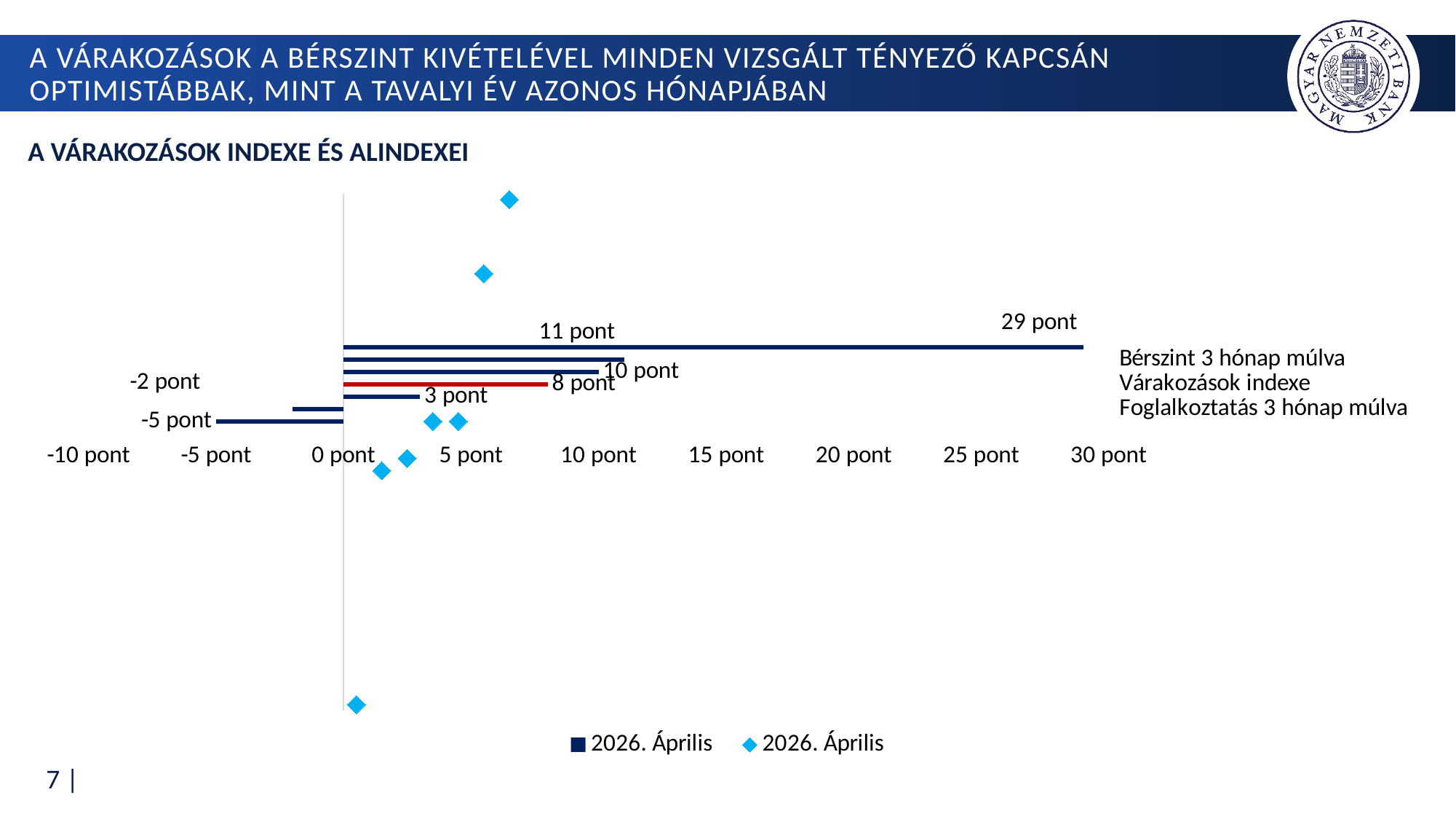
What is the highest value labelled on a bar in the chart? 29 pont How many bars carry a data label in the chart? 7 What is the highest tick value shown on the horizontal axis? 30 pont What is the difference between the longest bar (29 pont) and the bar labelled 11 pont? 18 pont What is the title of the chart? A VÁRAKOZÁSOK INDEXE ÉS ALINDEXEI What is the difference between the bars labelled 10 pont and 8 pont? 2 pont What kind of chart is shown on the slide? bar chart How many series does the legend list? 2 Is the longest bar in the chart greater or less than 25 pont? greater How many bars in the chart have negative values? 2 Which is larger, the bar labelled 11 pont or the bar labelled 10 pont? 11 pont What is the lowest value labelled on a bar in the chart? -5 pont